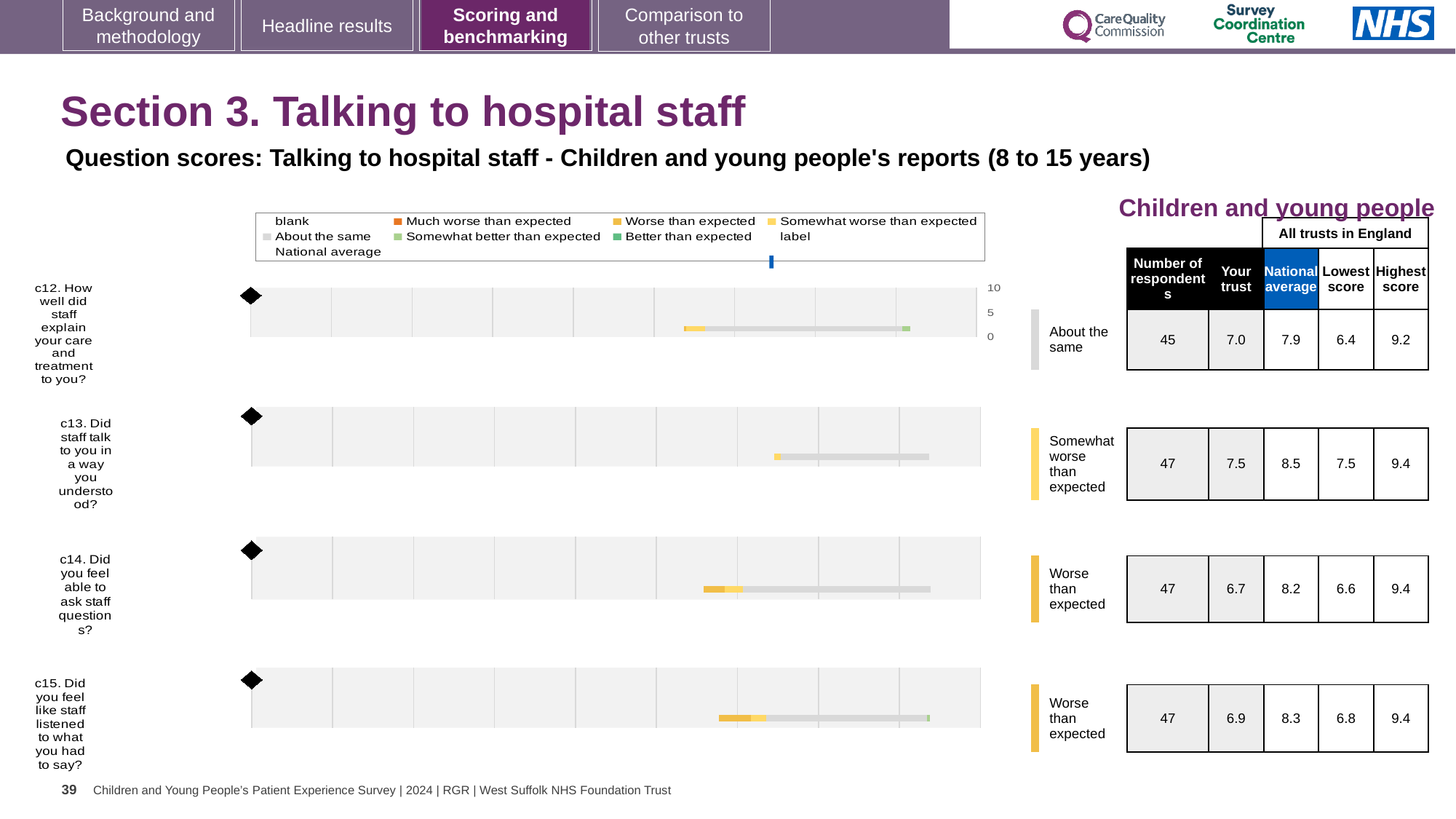
For c13 (Did staff talk to you in a way you understood?), what is the national average score? 8.5 What kind of chart is used for each question on this slide? bar chart For c14, what is the difference between the national average and the 'Your trust' score? 1.5 What benchmark category is shown for c13 (Did staff talk to you in a way you understood?)? Somewhat worse than expected Which question has the lowest 'Your trust' score? c14. Did you feel able to ask staff questions? Which question has the highest national average score? c13. Did staff talk to you in a way you understood? For c14 (Did you feel able to ask staff questions?), how many respondents are there? 47 For c15 (Did you feel like staff listened to what you had to say?), what is the highest score among all trusts in England? 9.4 For c12 (How well did staff explain your care and treatment to you?), what is the 'Your trust' score? 7.0 Which is larger: the 'Your trust' score for c12 or for c15? c12 How many survey questions are charted on this slide? 4 What benchmark category is shown for c12 (How well did staff explain your care and treatment to you?)? About the same